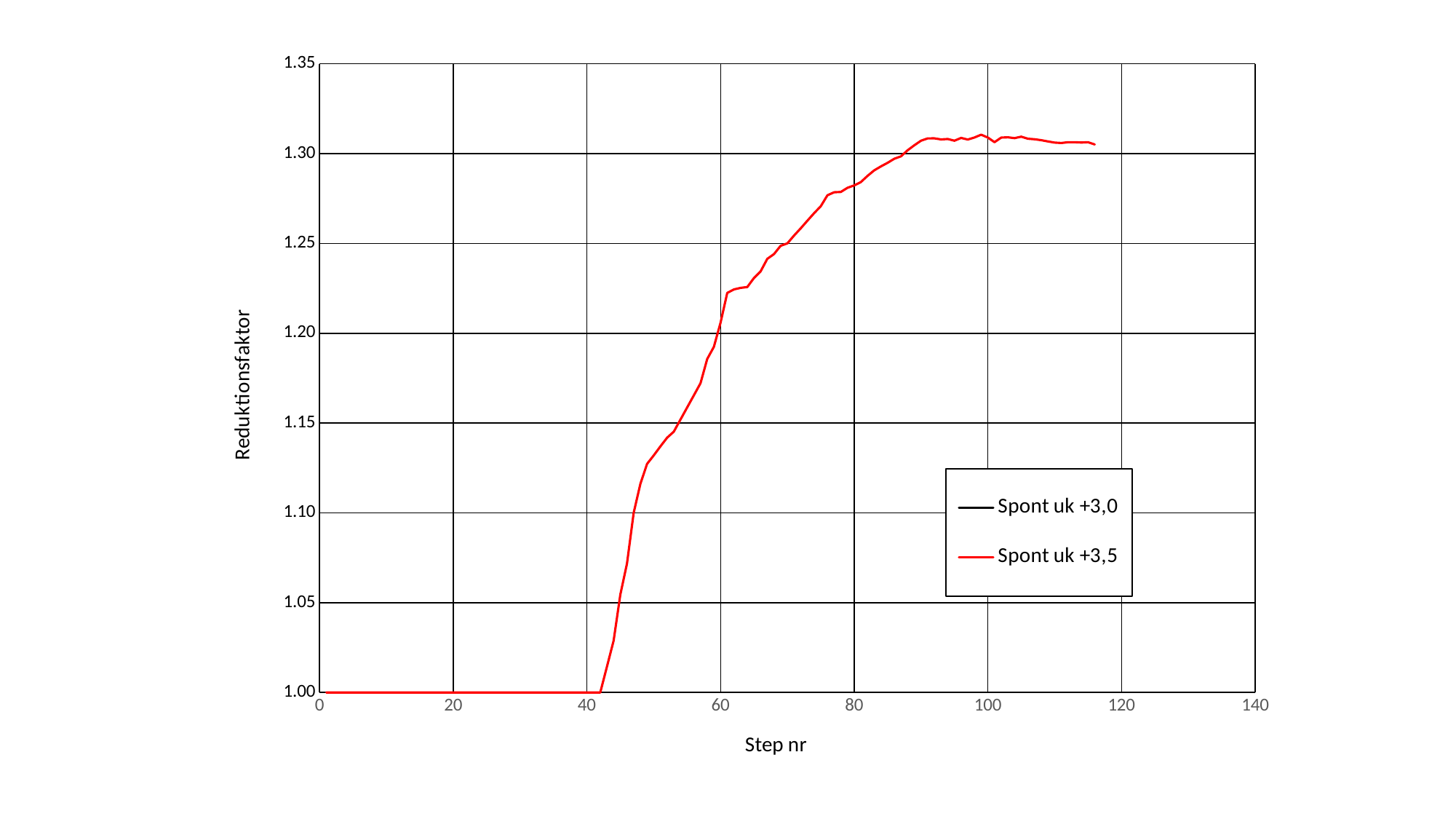
Is the value of the Spont uk +3,5 series at step 50 greater or less than 1.10? greater What kind of chart is shown on the slide? line chart How many series does the legend list? 2 Is the value of the Spont uk +3,5 series at step 80 greater or less than 1.25? greater Is the value of the Spont uk +3,5 series at step 100 larger or smaller than its value at step 60? larger Does the Spont uk +3,5 series rise or fall between step 40 and step 90? rise What is the title of the y axis? Reduktionsfaktor What is the title of the x axis? Step nr Is the value of the Spont uk +3,5 series at step 40 greater or less than 1.05? less What is the value of the Spont uk +3,5 series at step 20? 1.00